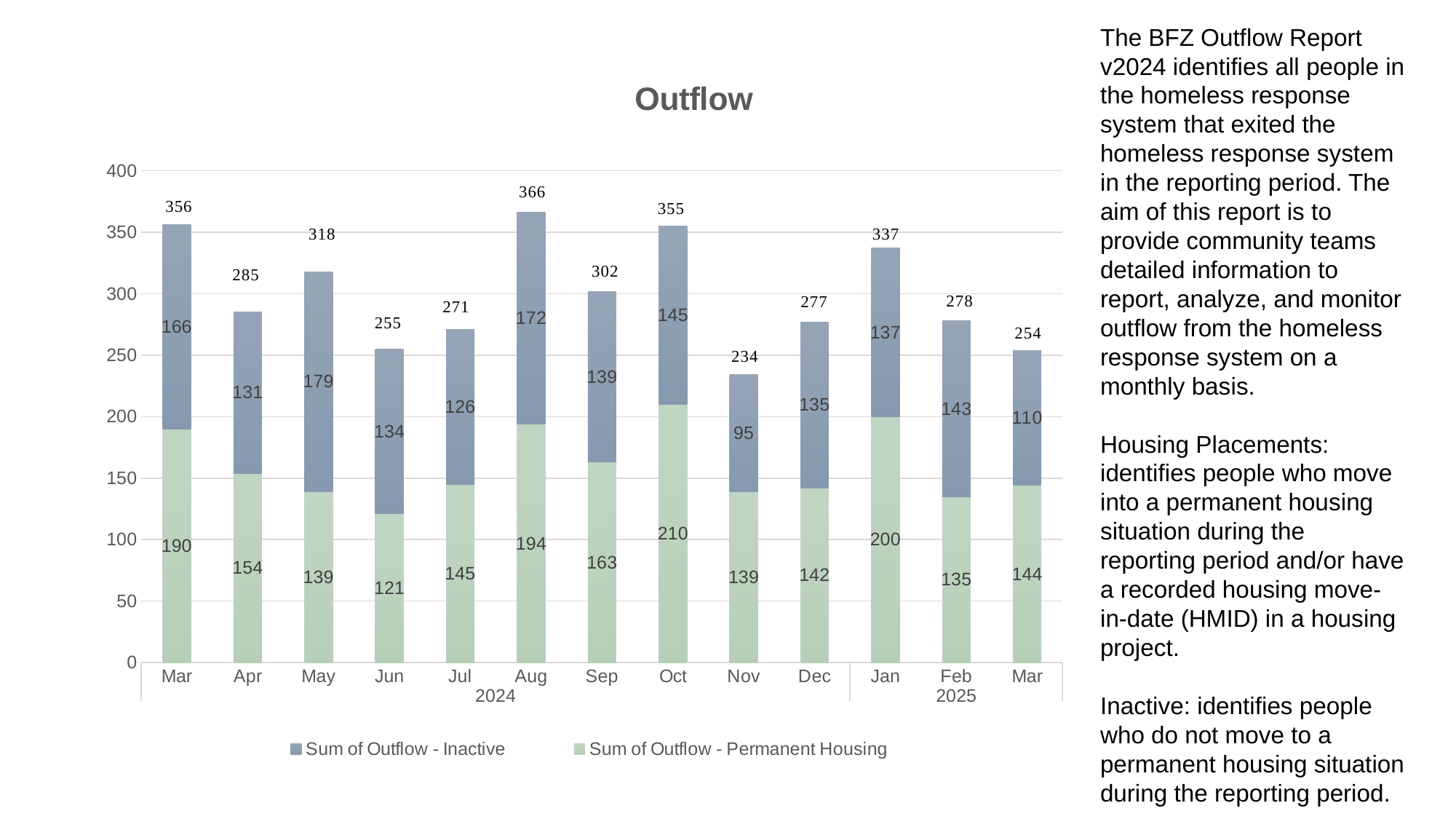
Which is larger for May 2024: Sum of Outflow - Inactive or Sum of Outflow - Permanent Housing? Sum of Outflow - Inactive What is the Sum of Outflow - Permanent Housing value for Oct 2024? 210 What is the Sum of Outflow - Inactive value for Nov 2024? 95 How many series does the legend list? 2 What is the title of the chart? Outflow Is the total outflow for Jan 2025 greater or less than 300? greater How many months are plotted on the x axis? 13 What is the total outflow for Aug 2024? 366 What is the difference between the total outflow for Mar 2024 and Mar 2025? 102 Which month has the lowest total outflow? Nov 2024 What type of chart is shown on the slide? Stacked bar chart Which month has the highest total outflow? Aug 2024